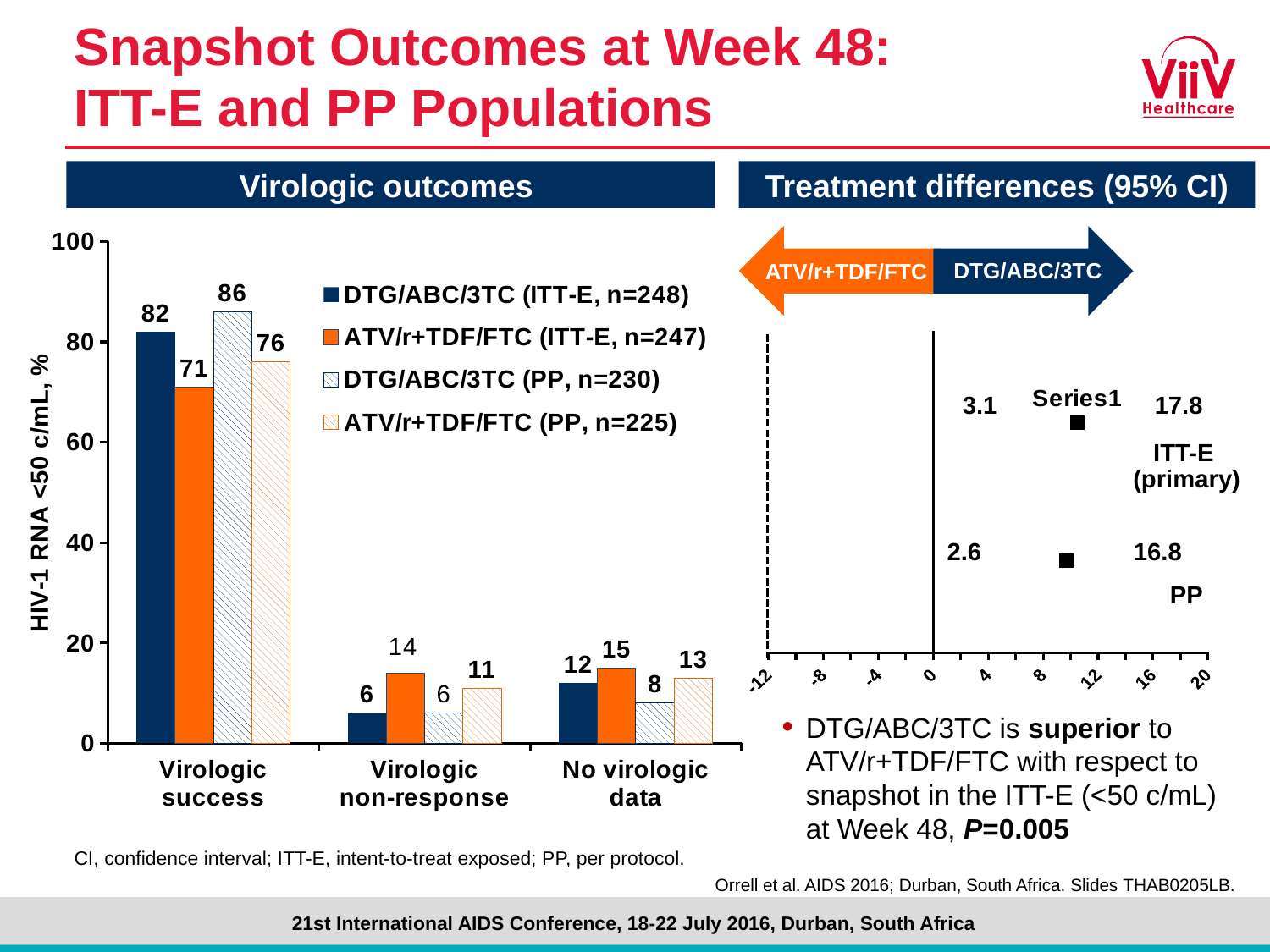
What kind of chart is the Virologic outcomes chart? Bar chart In the Virologic outcomes chart, what is the difference in virologic success between DTG/ABC/3TC (ITT-E) and ATV/r+TDF/FTC (ITT-E)? 11 In the Virologic outcomes chart, which series has the highest virologic success value? DTG/ABC/3TC (PP, n=230) In the Virologic outcomes chart, what is the virologic success rate for DTG/ABC/3TC in the ITT-E population? 82 In the Treatment differences chart, what is the upper bound of the 95% CI for the ITT-E (primary) analysis? 17.8 In the Virologic outcomes chart, what is the virologic success rate for ATV/r+TDF/FTC in the PP population? 76 How many outcome categories are shown on the x axis of the Virologic outcomes chart? 3 In the Virologic outcomes chart, which is larger for virologic non-response: ATV/r+TDF/FTC (ITT-E) or DTG/ABC/3TC (ITT-E)? ATV/r+TDF/FTC (ITT-E) In the Virologic outcomes chart, what is the value for no virologic data for DTG/ABC/3TC in the PP population? 8 What is the y-axis label of the Virologic outcomes chart? HIV-1 RNA <50 c/mL, % How many series does the legend of the Virologic outcomes chart list? 4 In the Treatment differences chart, what is the lower bound of the 95% CI for the PP analysis? 2.6